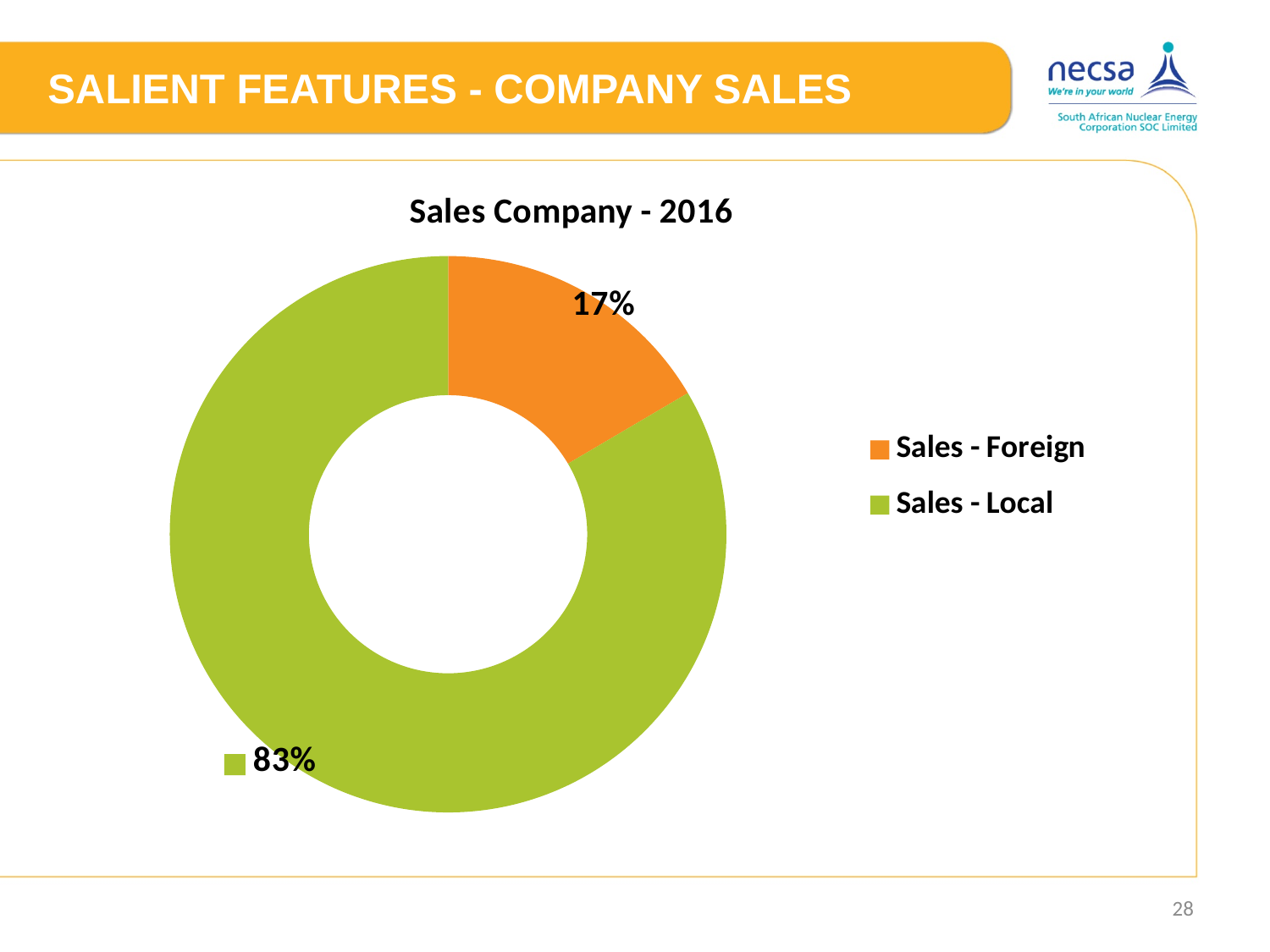
How many entries does the legend list? 2 What share of sales is Sales - Local? 83% What kind of chart is shown on the slide? Doughnut chart What share of sales is Sales - Foreign? 17% Which category has the largest share of the chart? Sales - Local What is the difference in percentage points between Sales - Local and Sales - Foreign? 66 What is the title of the chart? Sales Company - 2016 How many categories does the chart show? 2 Which category has the smallest share of the chart? Sales - Foreign What colour represents Sales - Local in the chart? Green Which is larger, Sales - Foreign or Sales - Local? Sales - Local